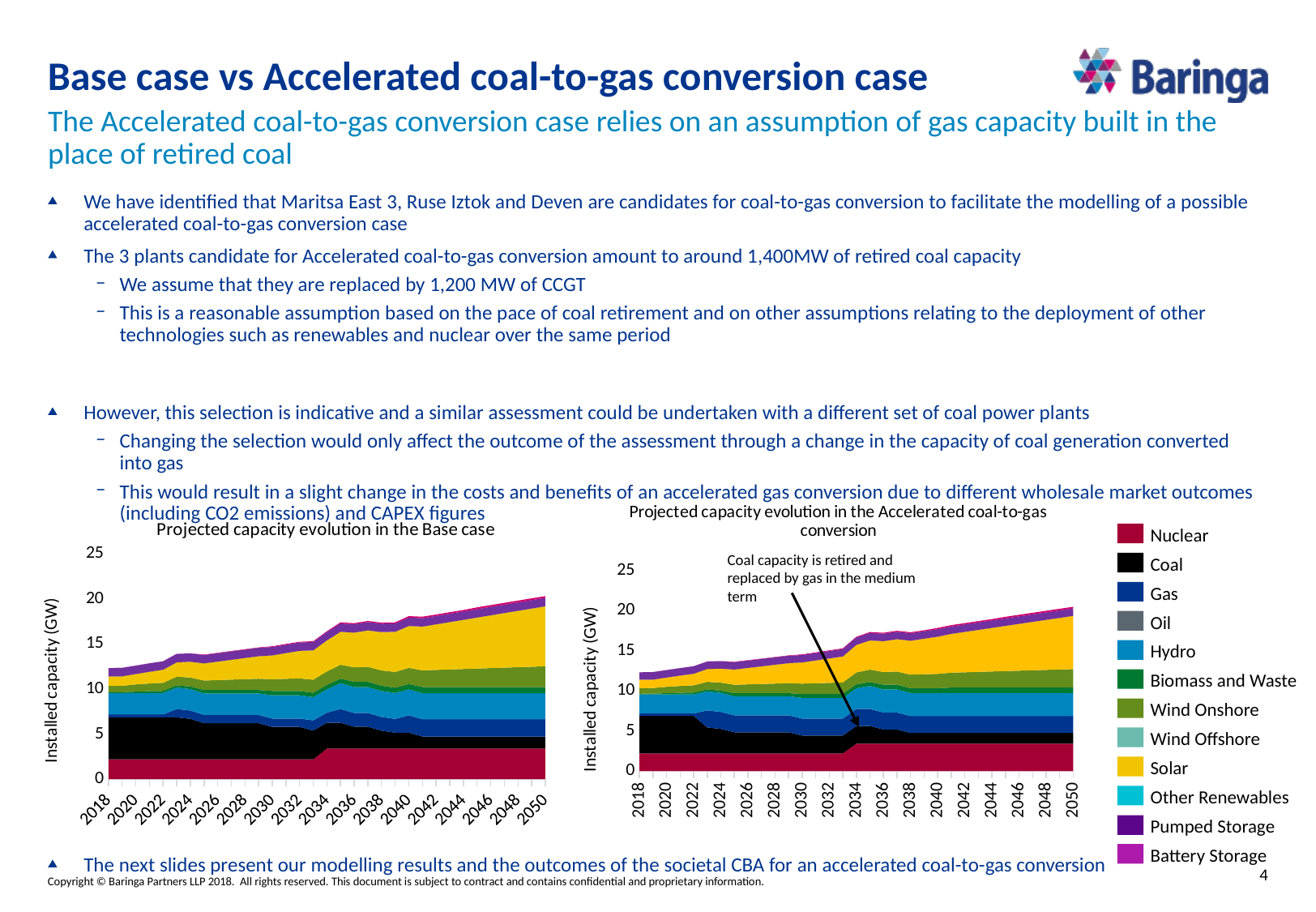
In the 'Projected capacity evolution in the Accelerated coal-to-gas conversion' chart, is the total installed capacity in 2018 greater or less than 10? greater In the 'Projected capacity evolution in the Base case' chart, does the total installed capacity rise or fall from 2018 to 2050? rises In the 'Projected capacity evolution in the Accelerated coal-to-gas conversion' chart, is the total installed capacity in 2050 greater or less than 15? greater In the capacity evolution charts, which series is shown in black? Coal In the 'Projected capacity evolution in the Base case' chart, is the total installed capacity in 2050 greater or less than 15? greater How many year labels are shown on the x axis of the 'Projected capacity evolution in the Base case' chart? 17 In the 'Projected capacity evolution in the Base case' chart, what is the label on the y axis? Installed capacity (GW) In the 'Projected capacity evolution in the Accelerated coal-to-gas conversion' chart, does the Coal capacity rise or fall from 2018 to 2050? falls How many series does the legend list for the capacity evolution charts? 12 What kind of chart is the 'Projected capacity evolution in the Base case' chart? stacked area chart